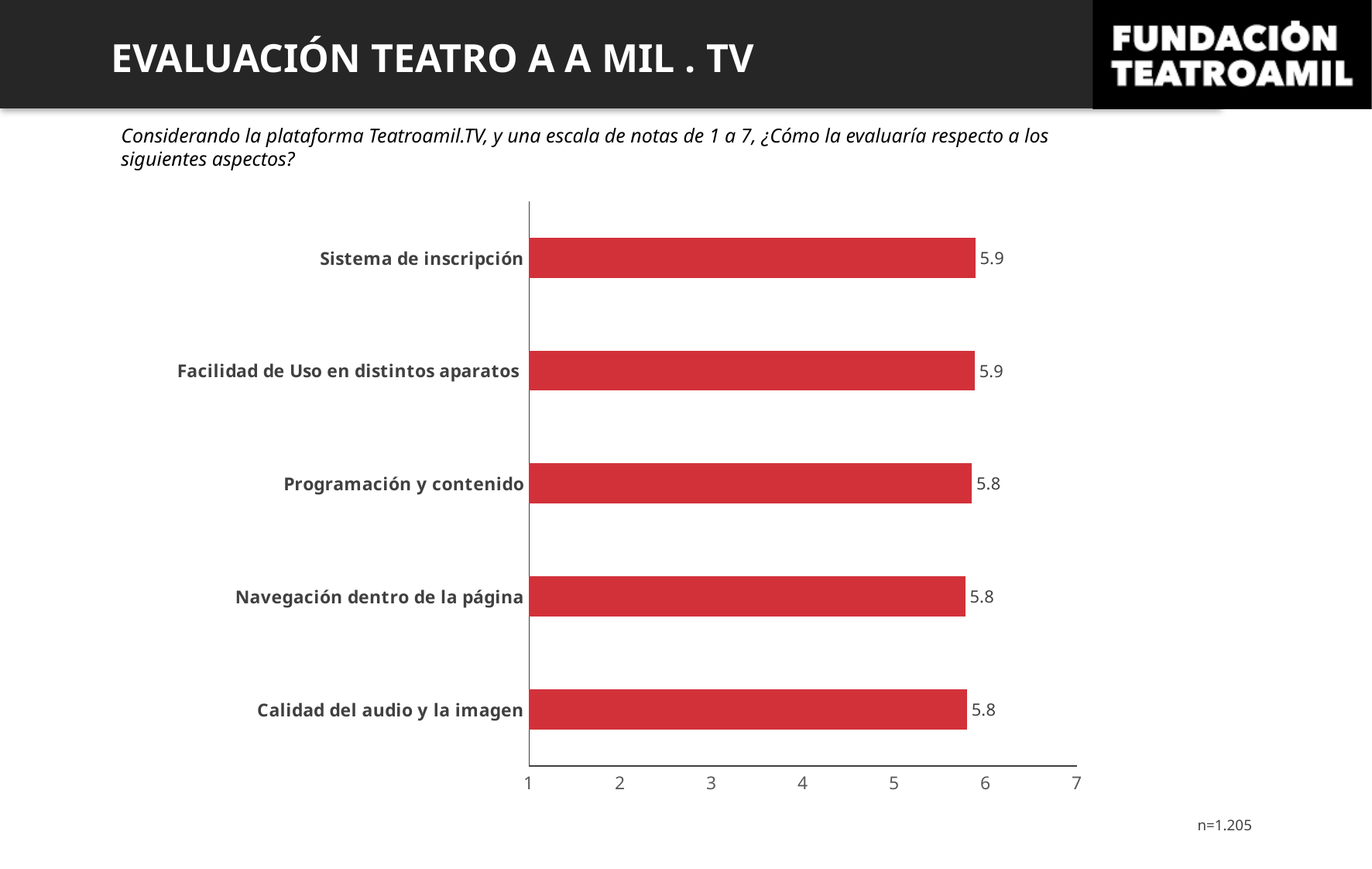
What is the value for Calidad del audio y la imagen? 5.8 What is the value for Programación y contenido? 5.8 Is the value for Programación y contenido greater or less than 5? greater What sample size is noted on the slide? n=1.205 What is the value for Navegación dentro de la página? 5.8 What is the difference between the values for Sistema de inscripción and Calidad del audio y la imagen? 0.1 What is the value for Facilidad de Uso en distintos aparatos? 5.9 Is the value for Sistema de inscripción greater or less than 6? less What kind of chart is shown on the slide? bar chart What is the value for Sistema de inscripción? 5.9 How many categories are shown in the chart? 5 What is the highest value shown on the x axis? 7